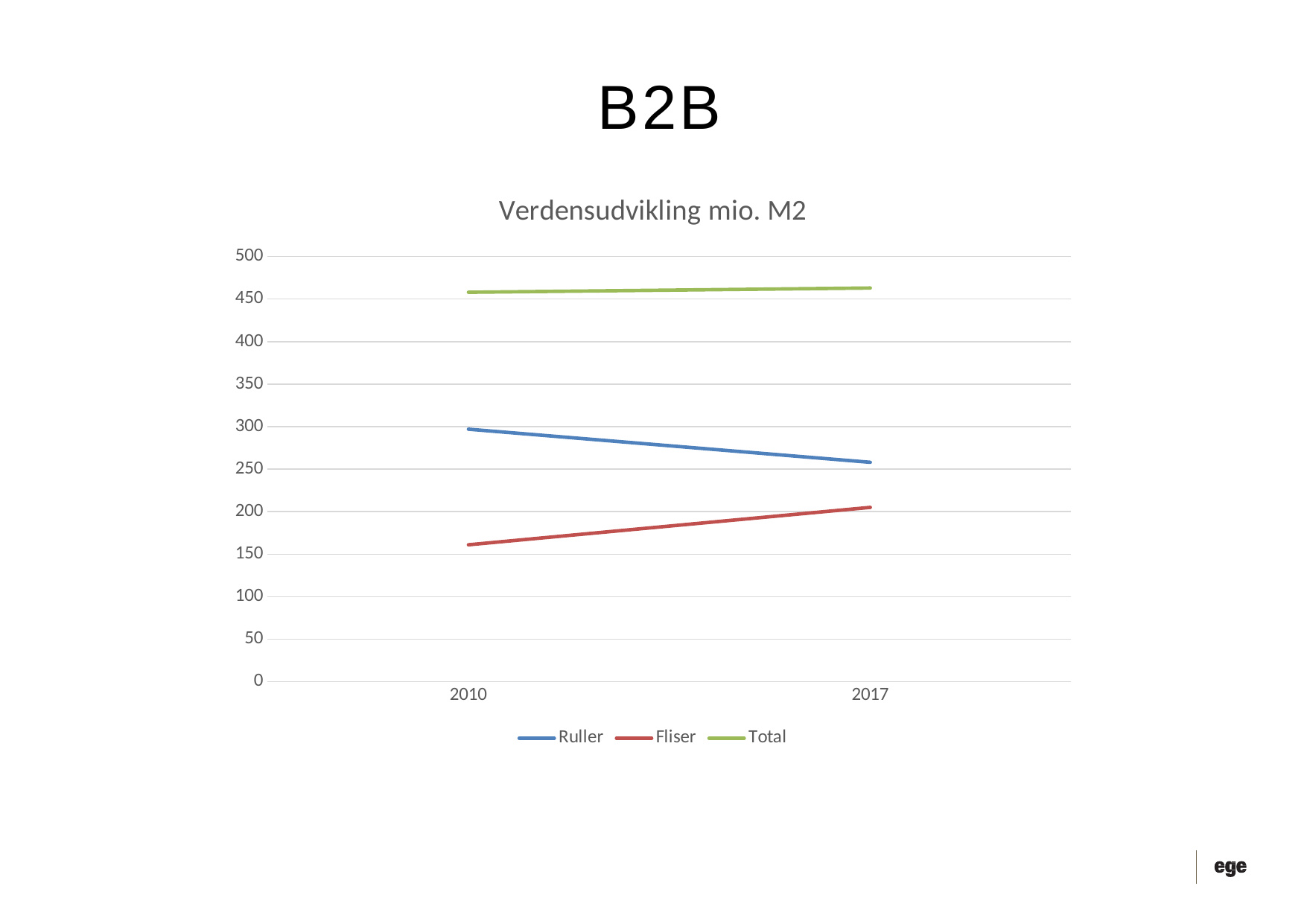
How many series does the legend list? 3 Does the Ruller series rise or fall from 2010 to 2017? fall Which series has the highest value in 2017? Total Which series has the lowest value in 2010? Fliser What kind of chart is shown on the slide? line chart Is the value for Total in 2010 greater or less than 400? greater Which series is drawn in green? Total Does the Fliser series rise or fall from 2010 to 2017? rise What is the title of the chart? Verdensudvikling mio. M2 How many points are on the x axis? 2 Is the value for Ruller in 2017 greater or less than 300? less In 2010, which is larger, Ruller or Fliser? Ruller